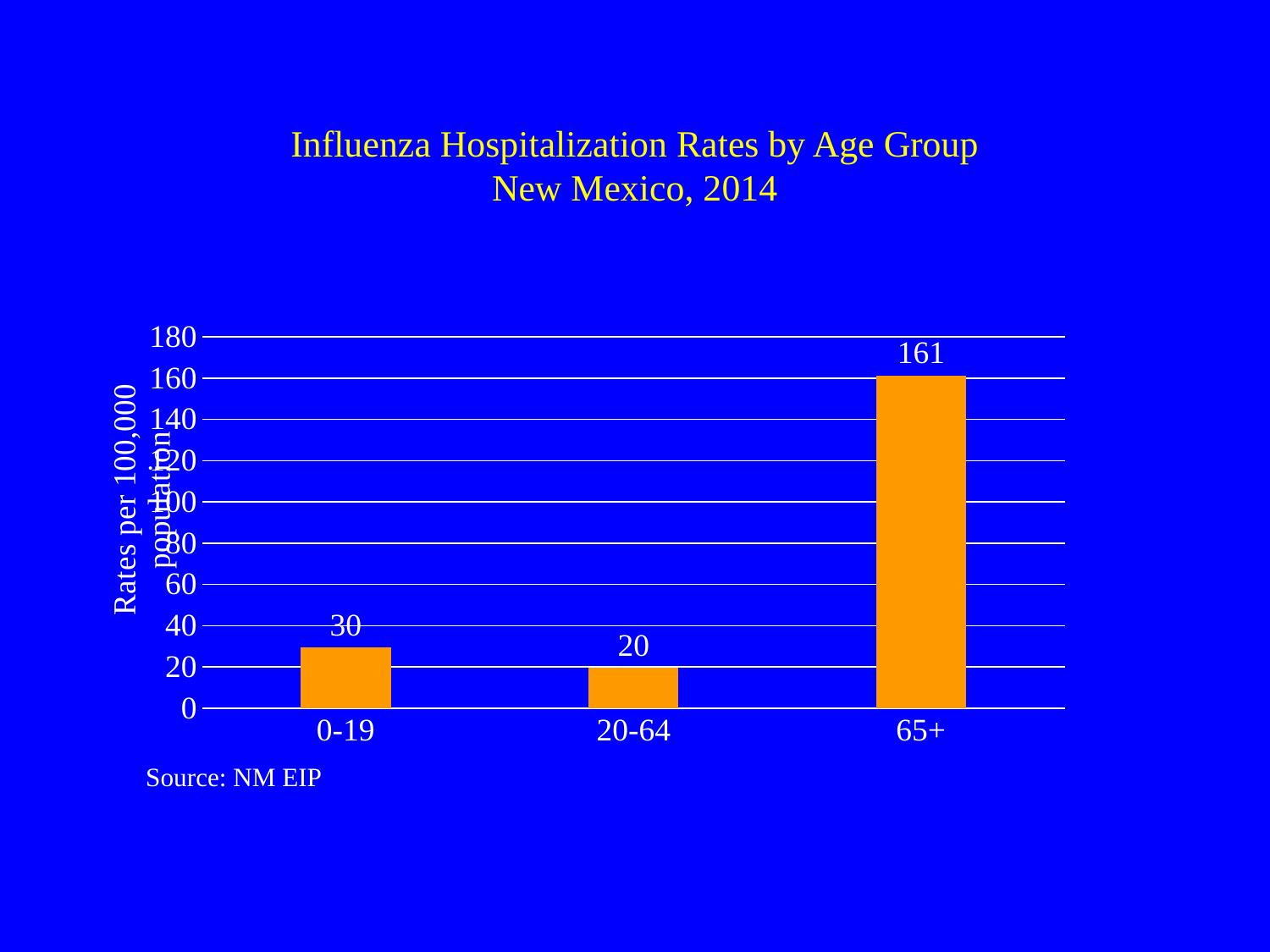
Is the hospitalization rate for the 65+ age group greater or less than 140? greater What is the source cited for the chart data? NM EIP What is the influenza hospitalization rate for the 20-64 age group? 20 Which age group has the lowest hospitalization rate? 20-64 Which age group has the highest hospitalization rate? 65+ What kind of chart is shown on the slide? bar chart What is the influenza hospitalization rate for the 0-19 age group? 30 What is the influenza hospitalization rate for the 65+ age group? 161 What is the difference between the hospitalization rates for the 65+ and 0-19 age groups? 131 How many age groups are shown in the chart? 3 What is the difference between the hospitalization rates for the 0-19 and 20-64 age groups? 10 Which age group has a higher hospitalization rate, 0-19 or 20-64? 0-19